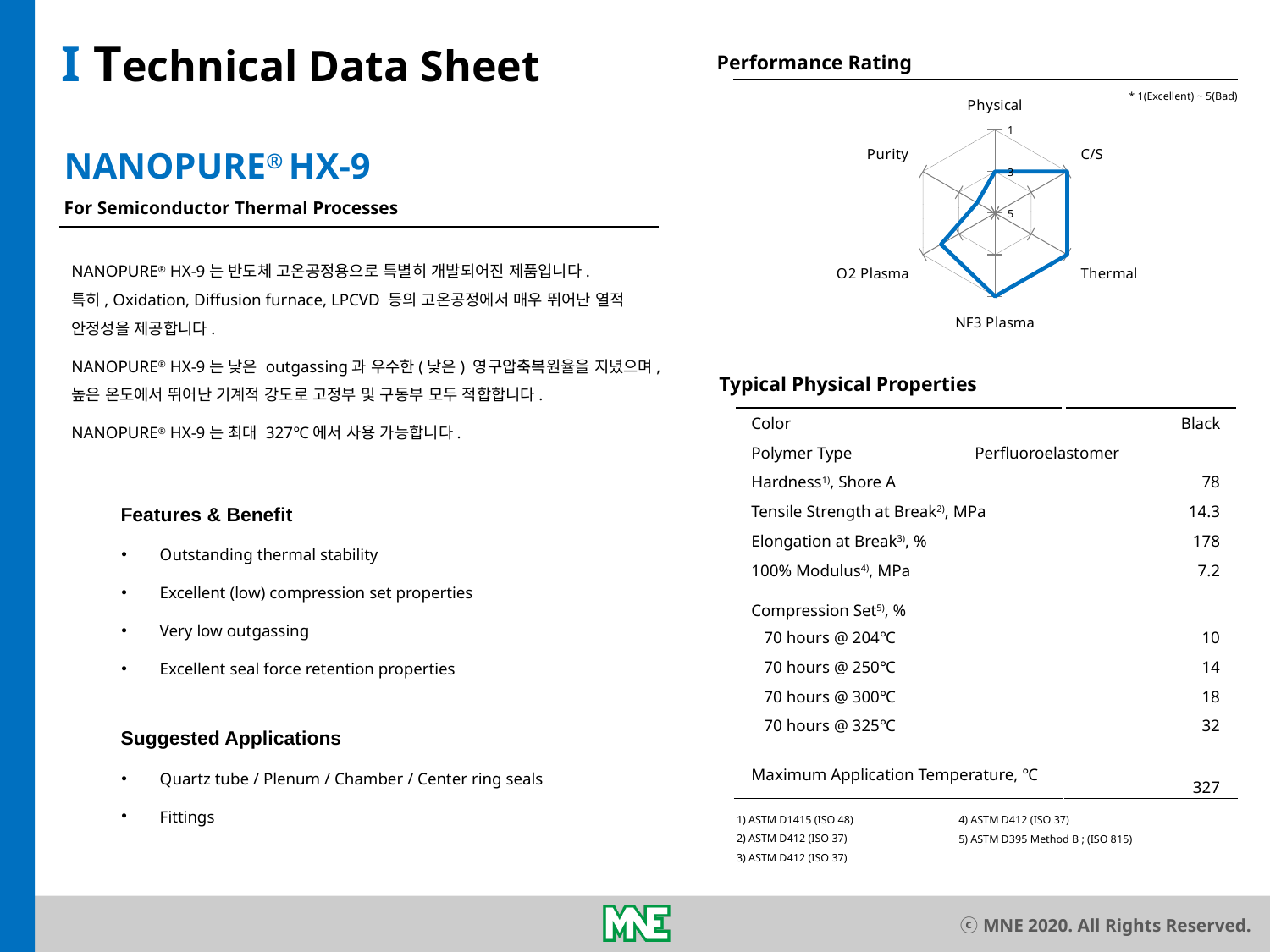
In the Performance Rating chart, is the value for Thermal greater or less than 3? less In the Performance Rating chart, which has the larger rating value, Purity or C/S? Purity What is the title of the chart on the slide? Performance Rating How many categories (axes) does the Performance Rating radar chart have? 6 In the Performance Rating chart, is the value for C/S greater or less than 3? less In the Performance Rating chart, is the value for O2 Plasma greater or less than 3? less In the Performance Rating chart, which has the larger rating value, Physical or Thermal? Physical In the Performance Rating chart, which category has the highest (worst) rating value? Purity What kind of chart is shown under the Performance Rating heading? Radar chart According to the note on the Performance Rating chart, what rating value means Excellent and what value means Bad? 1 is Excellent, 5 is Bad